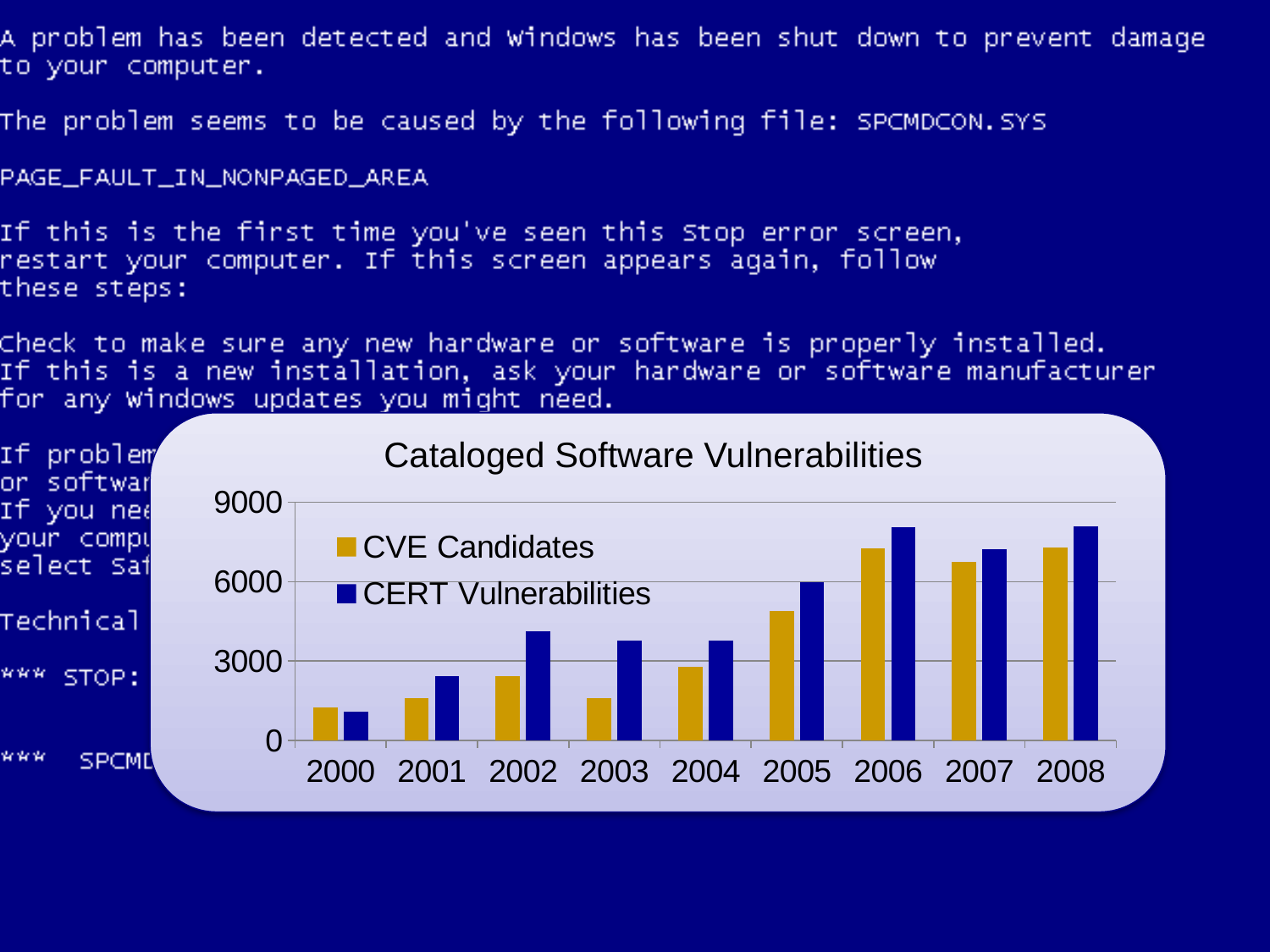
What kind of chart is shown on the slide? bar chart Do the CERT Vulnerabilities values rise or fall from 2000 to 2002? rise In 2001, which is larger: CVE Candidates or CERT Vulnerabilities? CERT Vulnerabilities How many series does the chart's legend list? 2 How many years are shown on the x axis of the chart? 9 Is the value for CVE Candidates in 2002 greater or less than 3000? less In which year is the CERT Vulnerabilities value lowest? 2000 Which series is drawn in blue? CERT Vulnerabilities Is the value for CERT Vulnerabilities in 2002 greater or less than 3000? greater What is the title of the chart? Cataloged Software Vulnerabilities Is the value for CVE Candidates in 2005 greater or less than 6000? less